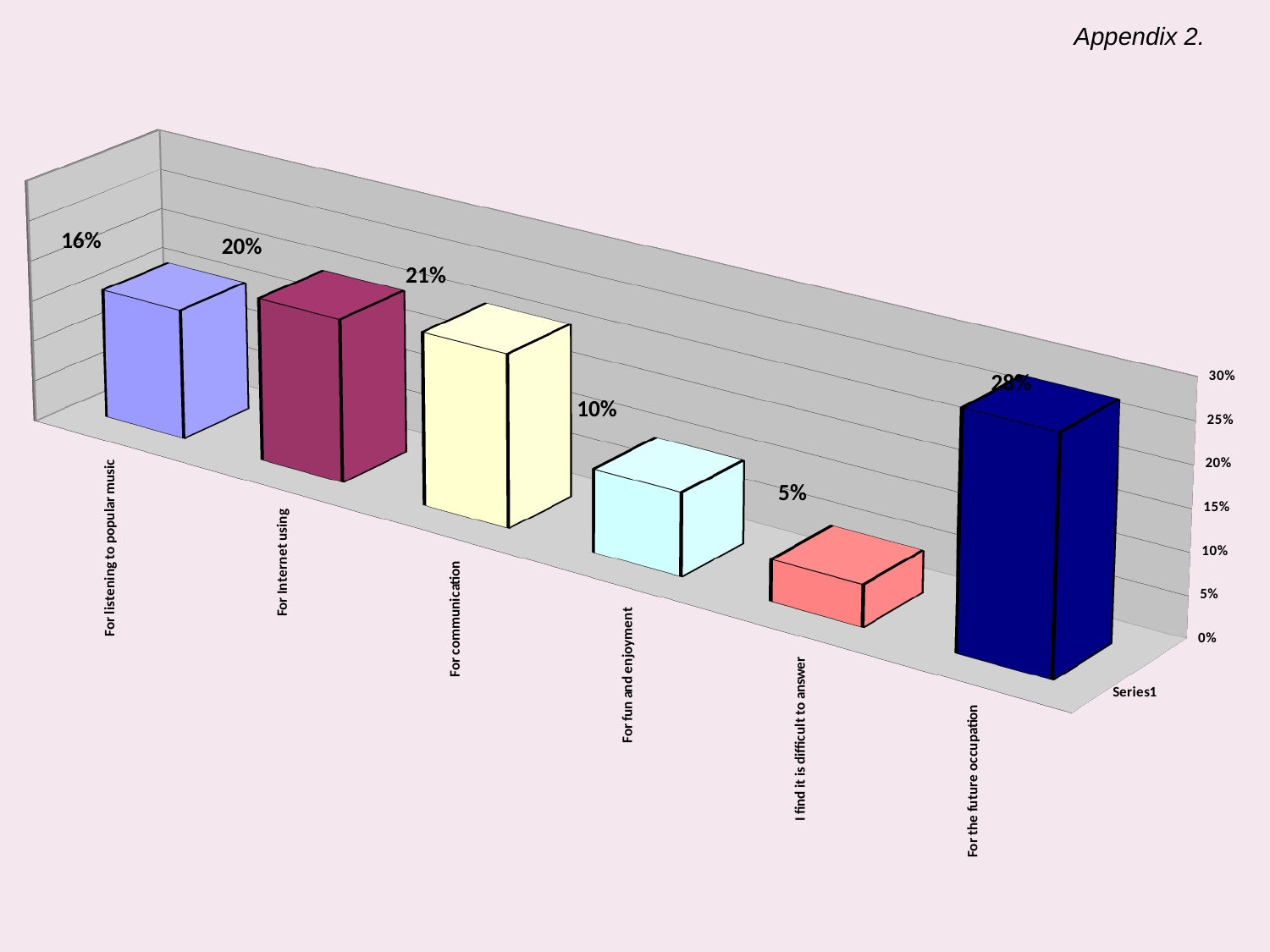
Which is larger, the value for 'For communication' or the value for 'For listening to popular music'? For communication What kind of chart is shown on the slide? Bar chart What is the difference between the values for 'For Internet using' and 'For fun and enjoyment'? 10% What is the value for 'For Internet using'? 20% Which category has the lowest value? I find it is difficult to answer How many categories are shown in the chart? 6 What is the value for 'I find it is difficult to answer'? 5% Which category has the highest value? For the future occupation What is the value for 'For communication'? 21% What is the value for 'For fun and enjoyment'? 10% What is the value for 'For listening to popular music'? 16% Is the value for 'For the future occupation' greater or less than 25%? greater